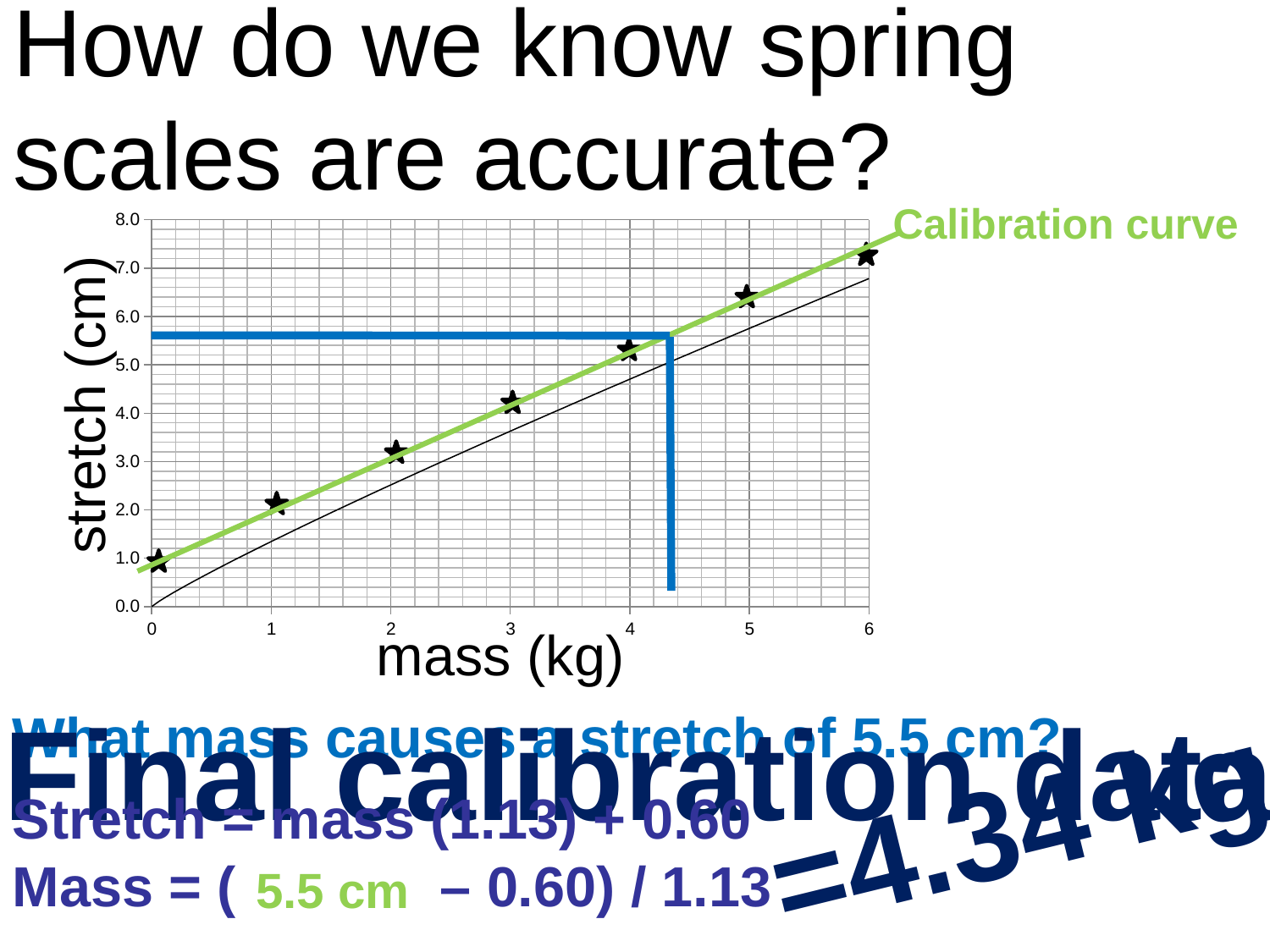
Is the plotted stretch at 6 kg greater or less than 6.0 cm? greater Is the plotted stretch at 5 kg greater or less than 6.0 cm? greater Which has the larger plotted stretch: the point at 5 kg or the point at 2 kg? 5 kg How many data points (stars) are plotted on the chart? 7 Is the plotted stretch at 3 kg greater or less than 4.0 cm? greater What label is given to the green line on the chart? Calibration curve At which mass is the plotted stretch highest? 6 kg At which mass is the plotted stretch lowest? 0 kg What kind of chart is shown on the slide? scatter chart Do the plotted stretch values rise or fall as mass increases along the x axis? rise What is the title of the chart's x axis? mass (kg)